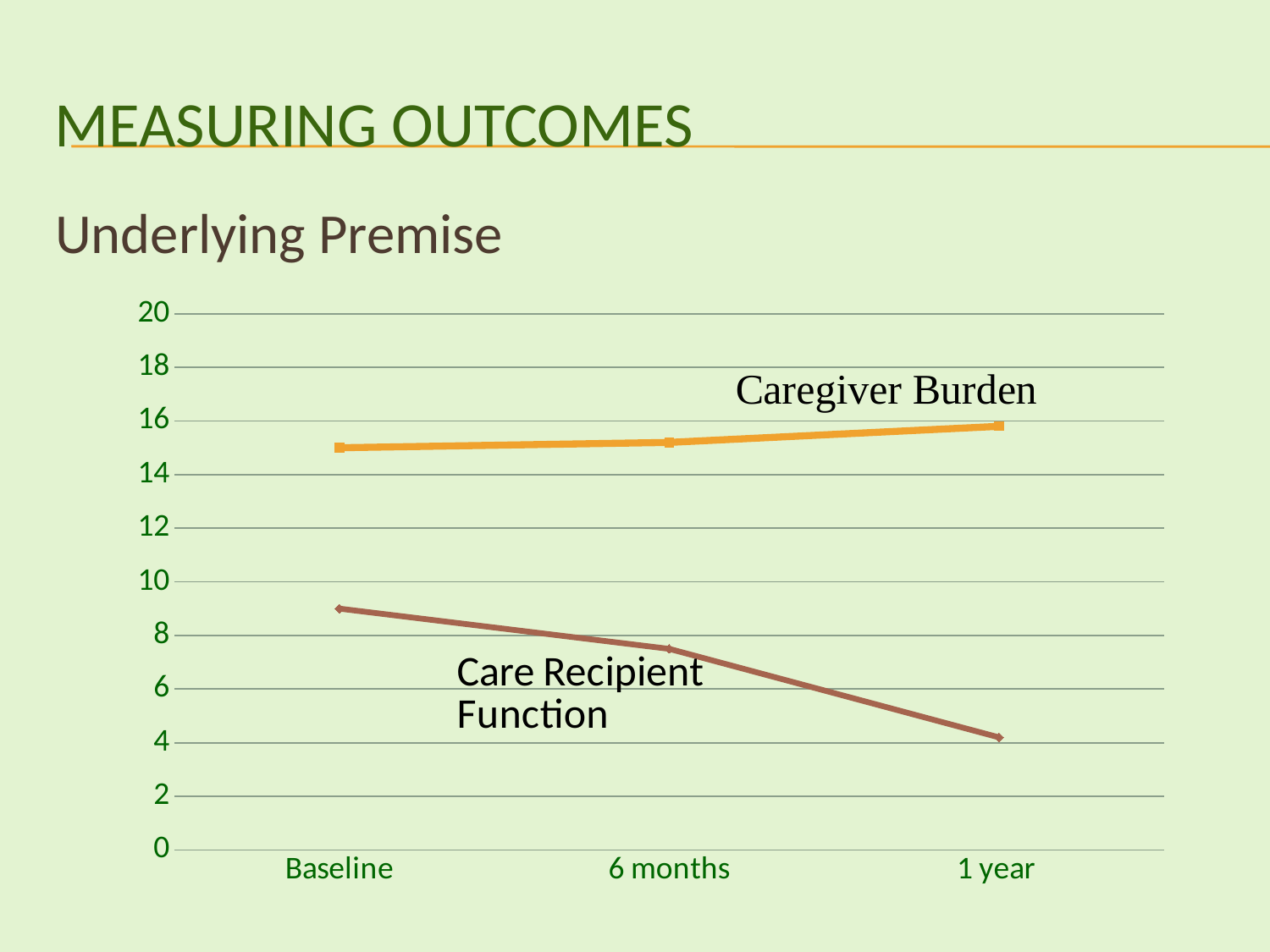
What kind of chart is shown on the slide? line chart Does the Care Recipient Function line rise or fall from Baseline to 1 year? fall Is the value for Care Recipient Function at Baseline greater or less than 8? greater At which time point is Care Recipient Function highest? Baseline At Baseline, which line is higher: Caregiver Burden or Care Recipient Function? Caregiver Burden Is the value for Care Recipient Function at 1 year greater or less than 6? less How many data series (lines) are plotted on the chart? 2 What are the labels of the two lines on the chart? Caregiver Burden and Care Recipient Function Is the value for Caregiver Burden at Baseline greater or less than 14? greater How many time points are plotted along the x axis? 3 At which time point is Care Recipient Function lowest? 1 year Does the Caregiver Burden line rise or fall from Baseline to 1 year? rise